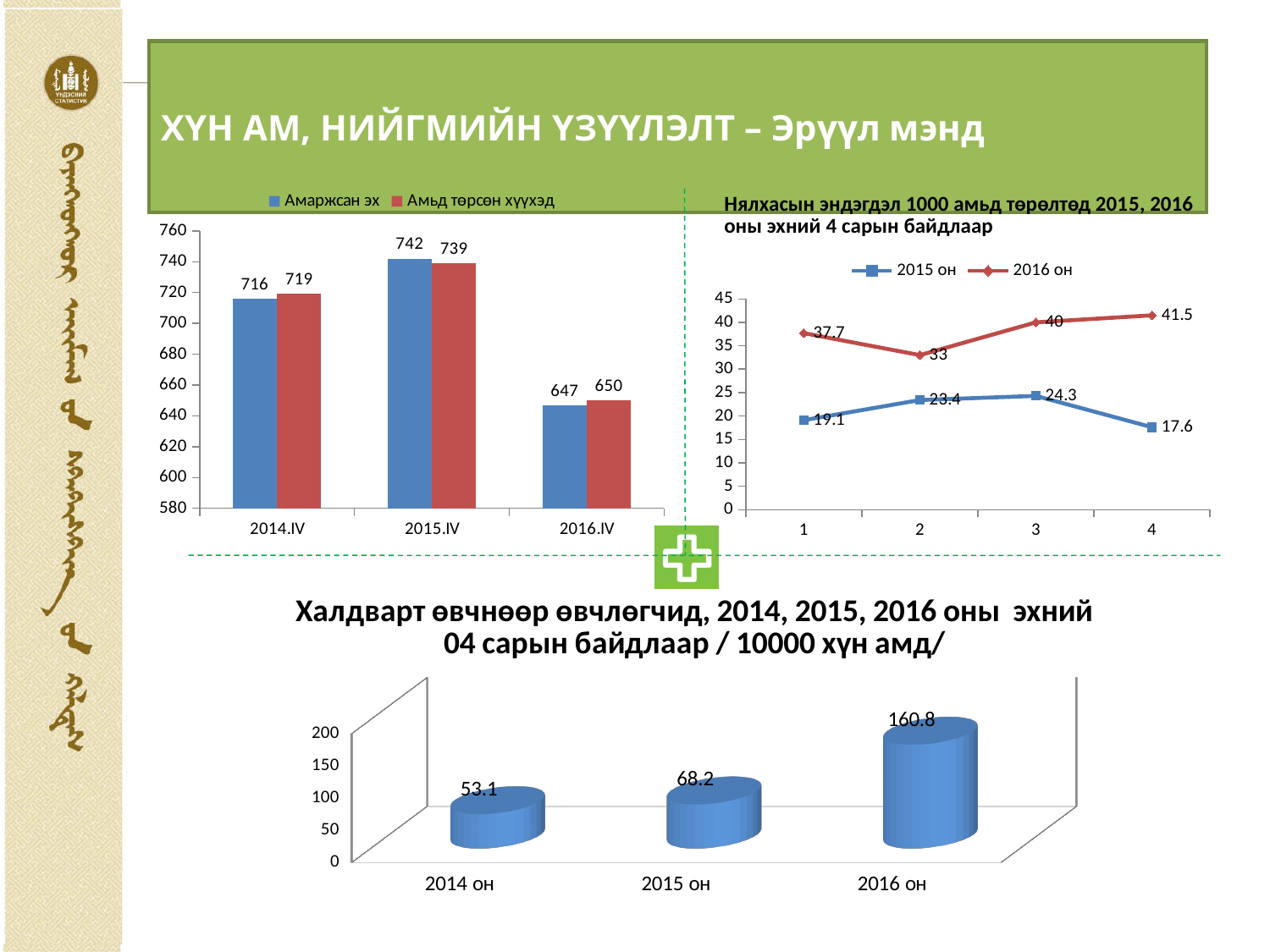
In the top-left bar chart, what is the value of Амьд төрсөн хүүхэд for 2015.IV? 739 In the top-left bar chart, which period has the lowest value for Амаржсан эх? 2016.IV How many series does the legend of the top-left bar chart list? 2 In the chart titled 'Нялхасын эндэгдэл 1000 амьд төрөлтөд 2015, 2016 оны эхний 4 сарын байдлаар', which is larger at point 2: 2015 он or 2016 он? 2016 он In the top-left bar chart, what is the difference between Амьд төрсөн хүүхэд and Амаржсан эх in 2016.IV? 3 In the chart titled 'Халдварт өвчнөөр өвчлөгчид, 2014, 2015, 2016 оны эхний 04 сарын байдлаар / 10000 хүн амд/', what is the value for 2016 он? 160.8 In the top-left bar chart, what is the value of Амаржсан эх for 2014.IV? 716 In the chart titled 'Нялхасын эндэгдэл 1000 амьд төрөлтөд 2015, 2016 оны эхний 4 сарын байдлаар', what is the difference between 2016 он and 2015 он at point 4? 23.9 What kind of chart is the chart titled 'Нялхасын эндэгдэл 1000 амьд төрөлтөд 2015, 2016 оны эхний 4 сарын байдлаар'? Line chart In the chart titled 'Халдварт өвчнөөр өвчлөгчид, 2014, 2015, 2016 оны эхний 04 сарын байдлаар / 10000 хүн амд/', do the values rise or fall from 2014 он to 2016 он? Rise In the chart titled 'Нялхасын эндэгдэл 1000 амьд төрөлтөд 2015, 2016 оны эхний 4 сарын байдлаар', what is the value for 2015 он at point 1? 19.1 In the chart titled 'Нялхасын эндэгдэл 1000 амьд төрөлтөд 2015, 2016 оны эхний 4 сарын байдлаар', what is the value for 2016 он at point 4? 41.5